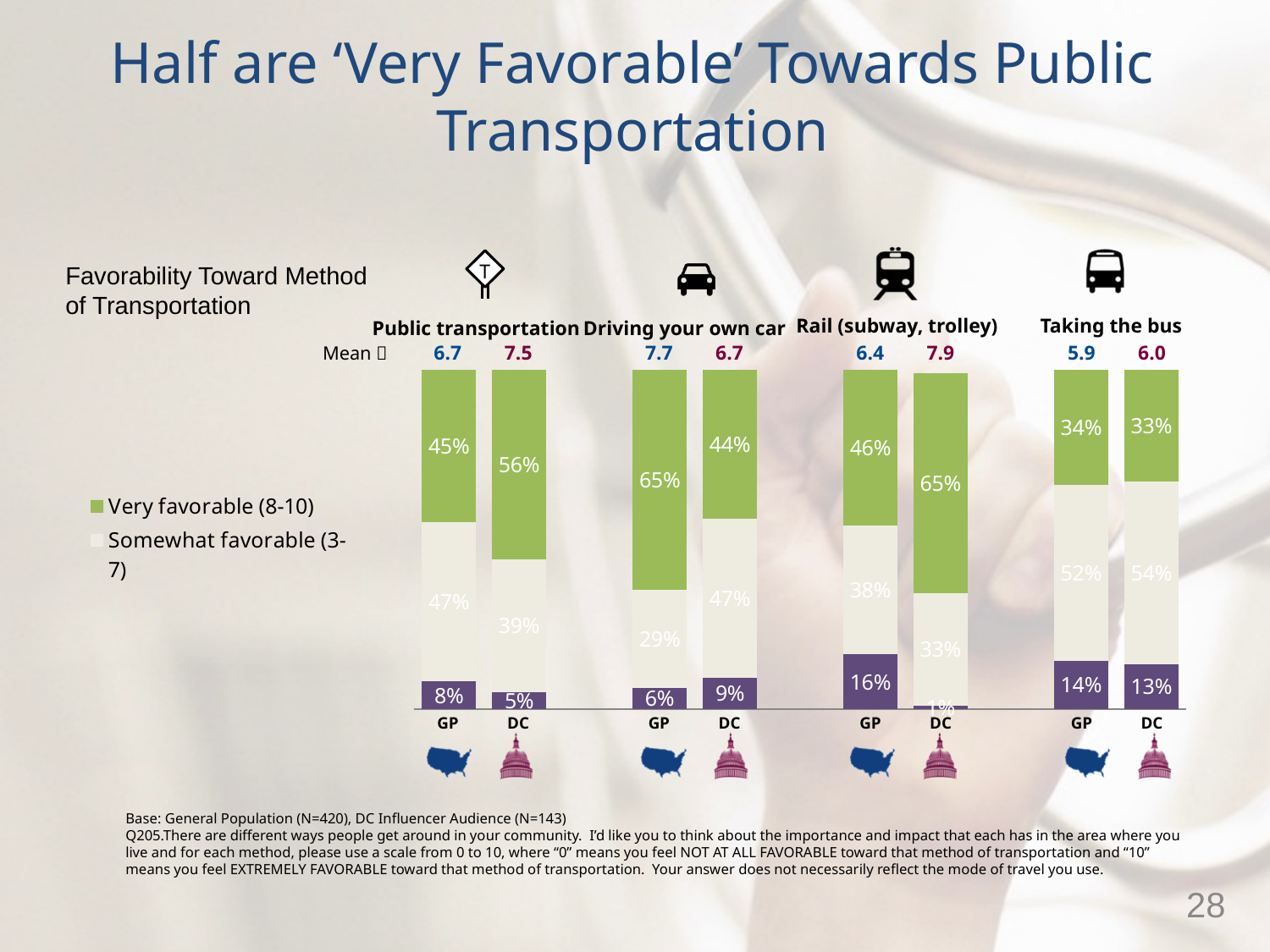
Which is larger: the GP 'Very favorable' share for driving your own car or the DC 'Very favorable' share for driving your own car? GP How many entries does the legend list? 2 What percentage of the General Population (GP) is 'Somewhat favorable' toward taking the bus? 52% What percentage of the General Population (GP) is 'Very favorable' toward public transportation? 45% Which transportation method has the highest mean favorability score among the DC audience? Rail (subway, trolley) What is the mean favorability score for driving your own car among the DC audience? 6.7 What is the difference between the DC and GP 'Very favorable' percentages for public transportation? 11 percentage points Which transportation method has the lowest mean favorability score among the General Population (GP)? Taking the bus What colour represents 'Very favorable (8-10)' in the chart? Green What type of chart is shown on the slide? Stacked bar chart What percentage of the DC audience is 'Very favorable' toward rail (subway, trolley)? 65% How many transportation methods are shown in the chart? 4